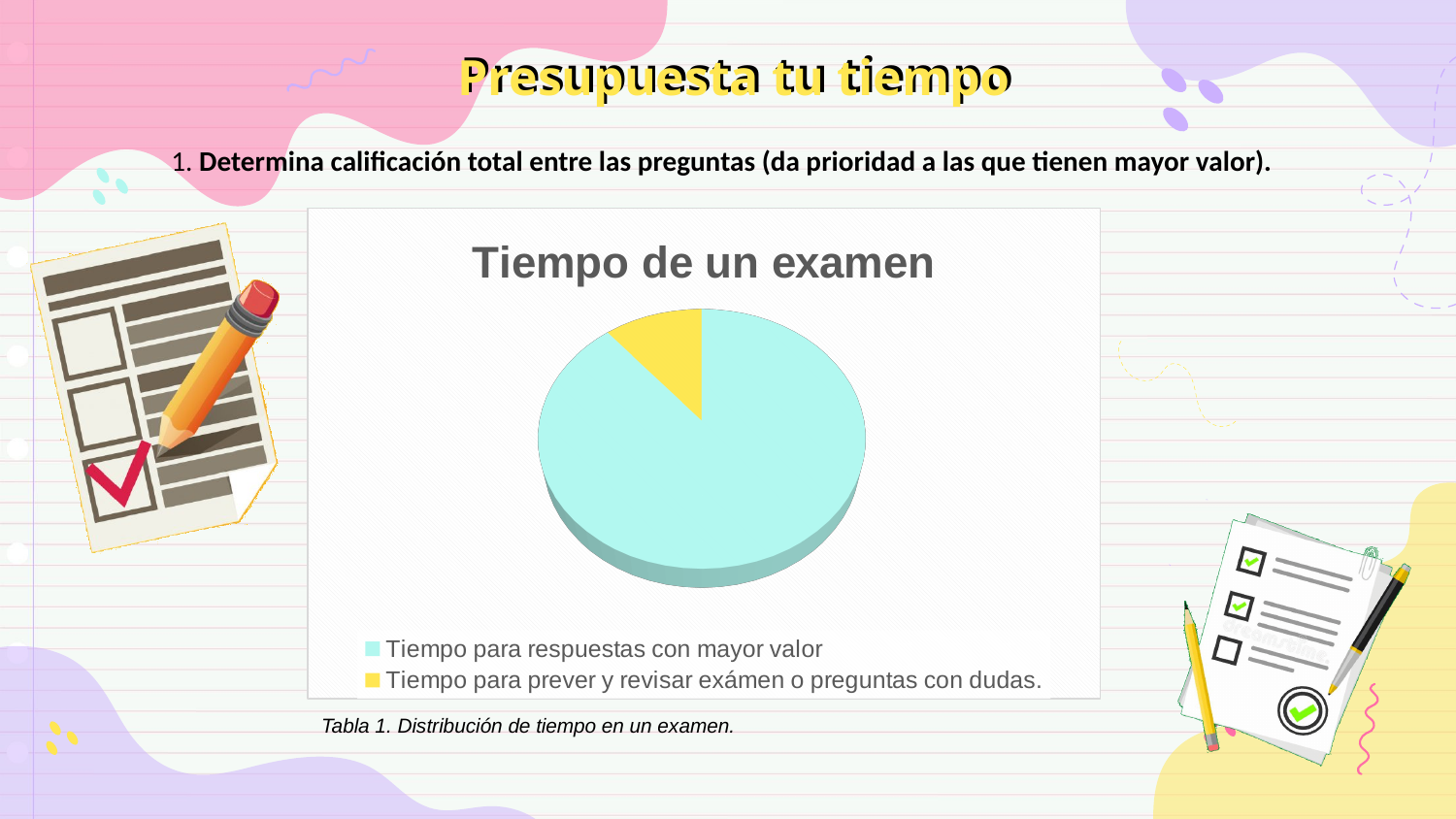
Which is larger: the slice for 'Tiempo para respuestas con mayor valor' or the slice for 'Tiempo para prever y revisar exámen o preguntas con dudas.'? Tiempo para respuestas con mayor valor What colour is the slice for 'Tiempo para prever y revisar exámen o preguntas con dudas.'? yellow How many slices does the pie chart have? 2 Which category takes the smallest share of the pie? Tiempo para prever y revisar exámen o preguntas con dudas. What kind of chart is shown on the slide? pie chart How many entries does the chart legend list? 2 What is the title of the chart? Tiempo de un examen Which category takes the largest share of the pie? Tiempo para respuestas con mayor valor